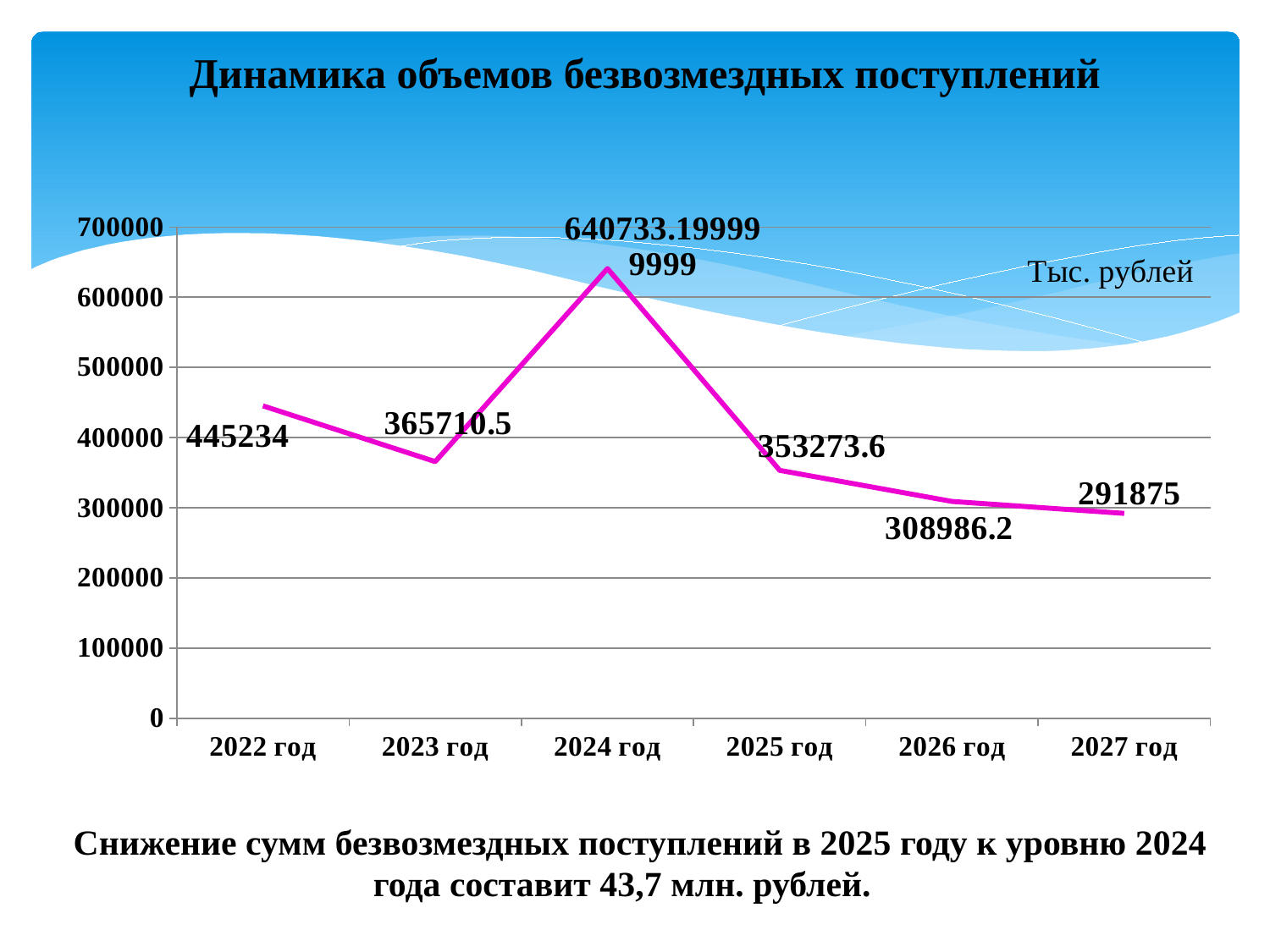
What is the difference between the values for 2022 год and 2023 год? 79523.5 What is the value for 2023 год? 365710.5 What kind of chart is shown on the slide? line chart What is the value for 2027 год? 291875 What is the value for 2022 год? 445234 What is the value for 2025 год? 353273.6 What is the value for 2026 год? 308986.2 Which is larger, the value for 2025 год or the value for 2026 год? 2025 год How many years are plotted on the chart? 6 Which year has the highest value? 2024 год Is the value for 2024 год greater or less than 600000? greater Which year has the lowest value? 2027 год